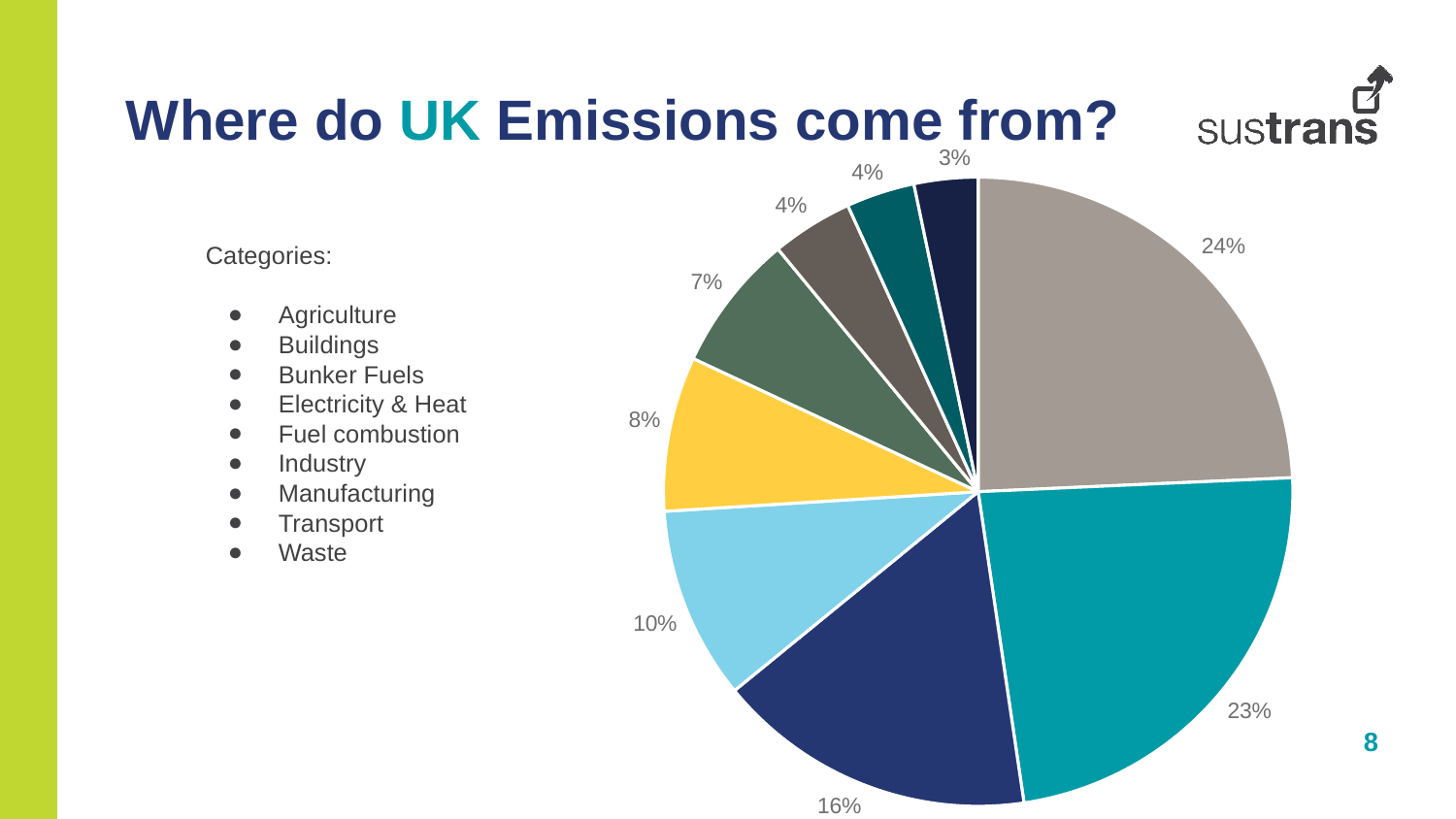
What is the value of the smallest slice in the pie chart? 3% How many slices does the pie chart have? 9 What is the value of the largest slice in the pie chart? 24% How many slices in the pie chart are labelled 4%? 2 How many categories are listed in the bulleted list next to the pie chart? 9 Which is larger, the slice labelled 16% or the slice labelled 10%? The slice labelled 16% What is the difference between the two largest slices, 24% and 23%? 1% What is the combined share of the two largest slices (24% and 23%)? 47% What is the title of the slide containing the pie chart? Where do UK Emissions come from? What kind of chart is shown on the slide? Pie chart What is the difference between the largest slice (24%) and the smallest slice (3%)? 21% What is the value of the second-largest slice in the pie chart? 23%